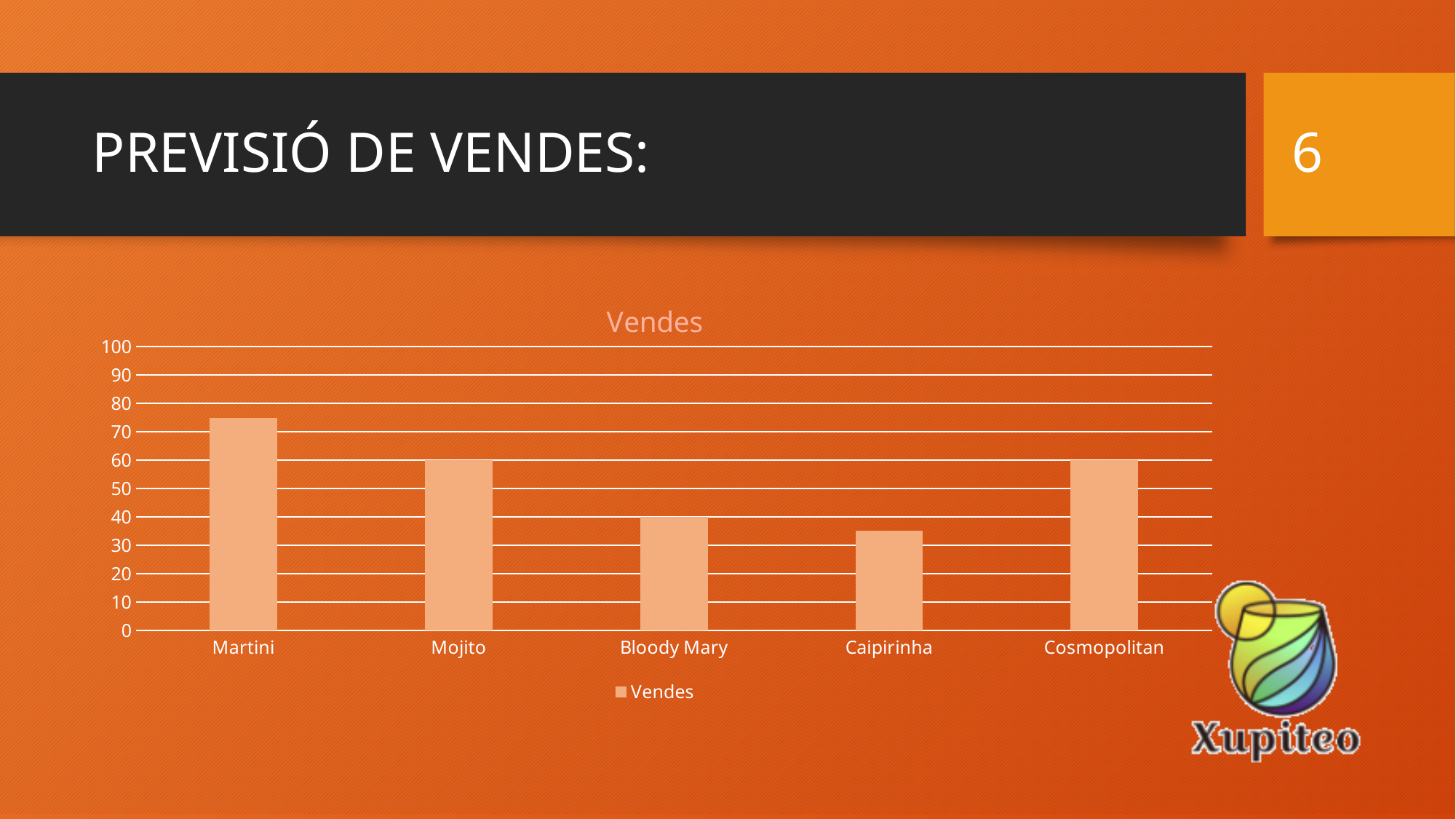
Which category has the lowest value? Caipirinha How many categories are shown on the x axis of the chart? 5 Is the value for Caipirinha greater or less than 40? less What is the title of the chart? Vendes Is the value for Martini greater or less than 70? greater What is the difference between the values for Mojito and Bloody Mary? 20 What is the value for Cosmopolitan? 60 Which category has the highest value? Martini What is the value for Bloody Mary? 40 What is the value for Mojito? 60 How many series does the legend list? 1 What type of chart is shown on the slide? bar chart